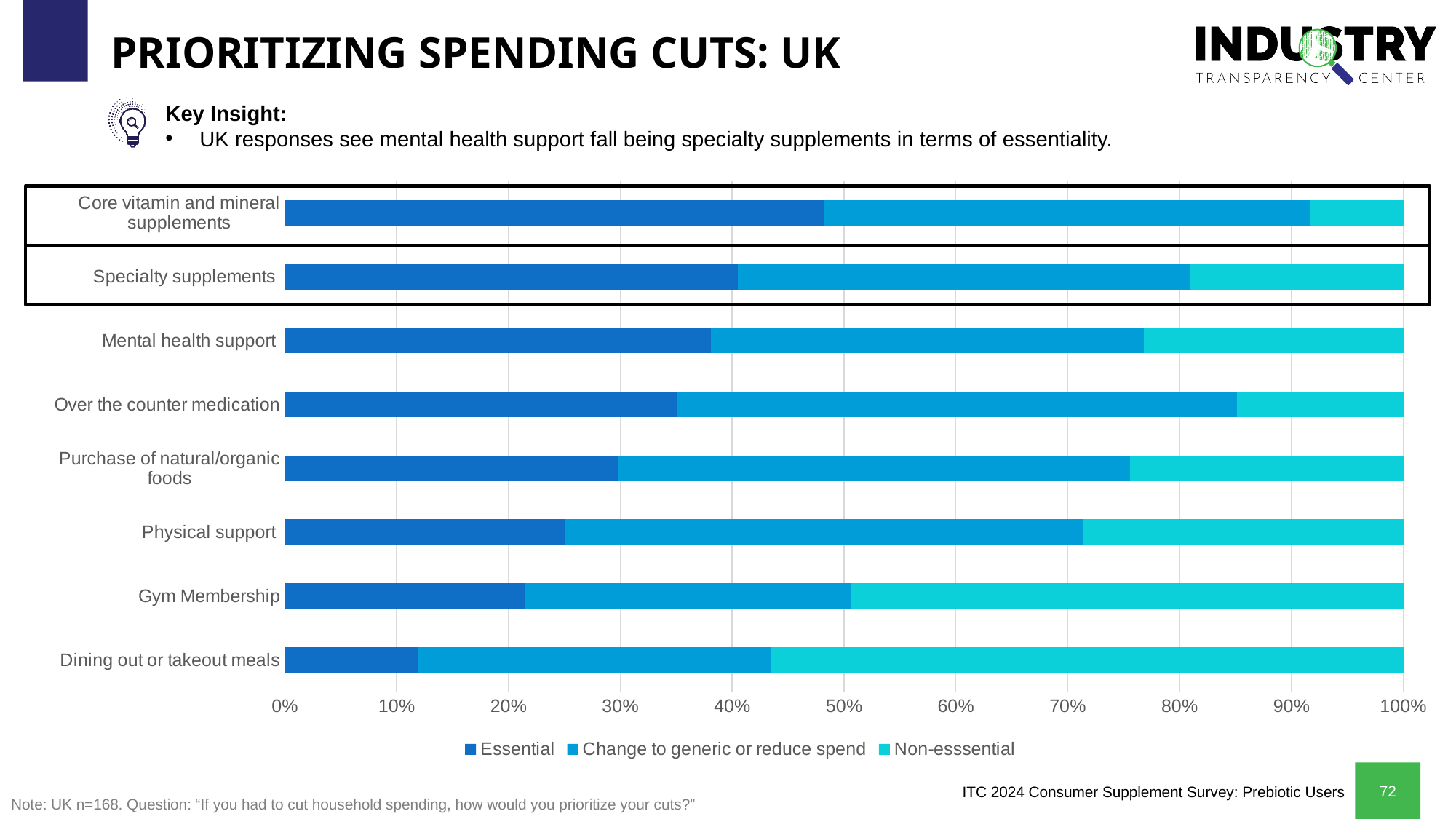
What does each stacked bar total on the x axis? 100% Which has a larger Essential share: Mental health support or Physical support? Mental health support How many series does the chart legend list? 3 Is the Non-esssential share for Dining out or takeout meals greater or less than 50%? greater Which two categories are outlined with black boxes on the chart? Core vitamin and mineral supplements and Specialty supplements Which category has the smallest Essential share? Dining out or takeout meals How many spending categories are plotted on the chart? 8 Is the Essential share for Gym Membership greater or less than 30%? less Which category has the largest Non-esssential share? Dining out or takeout meals What kind of chart is shown on the slide? Stacked bar chart Which category has the largest Essential share? Core vitamin and mineral supplements Is the Essential share for Core vitamin and mineral supplements greater or less than 40%? greater